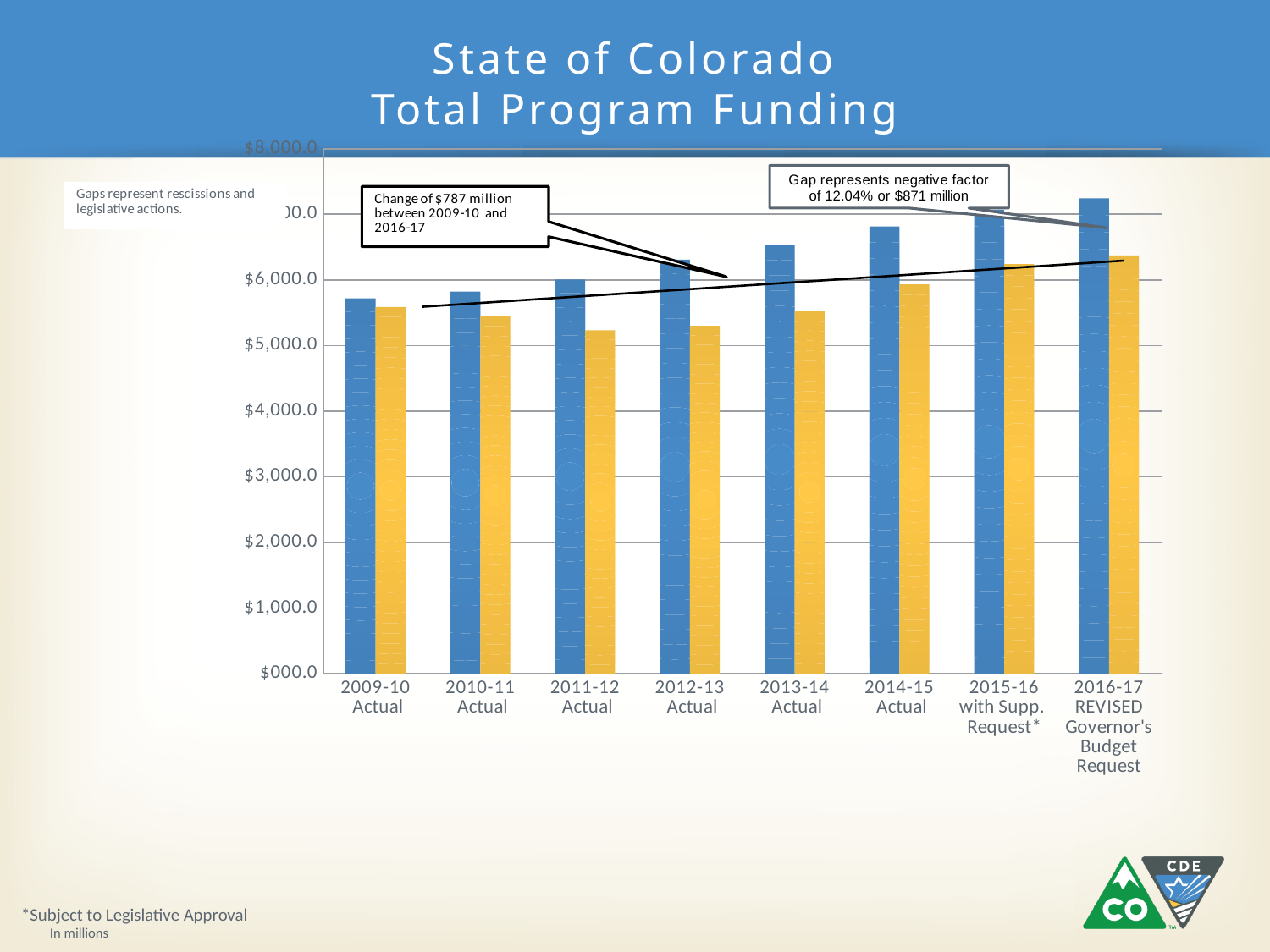
What kind of chart is shown on the slide? bar chart Do the blue bars rise or fall from 2009-10 to 2016-17 along the x axis? rise What is the title of the chart? State of Colorado Total Program Funding Is the blue bar for 2013-14 Actual greater or less than $6,000.0? greater Is the yellow bar for 2011-12 Actual greater or less than $6,000.0? less Which category has the shortest blue bar? 2009-10 Actual Is the blue bar for 2009-10 Actual greater or less than $5,000.0? greater Which category has the tallest yellow bar? 2016-17 REVISED Governor's Budget Request How many fiscal-year categories are shown on the x axis? 8 In 2009-10 Actual, which bar is taller, the blue bar or the yellow bar? the blue bar Which category has the tallest blue bar? 2016-17 REVISED Governor's Budget Request